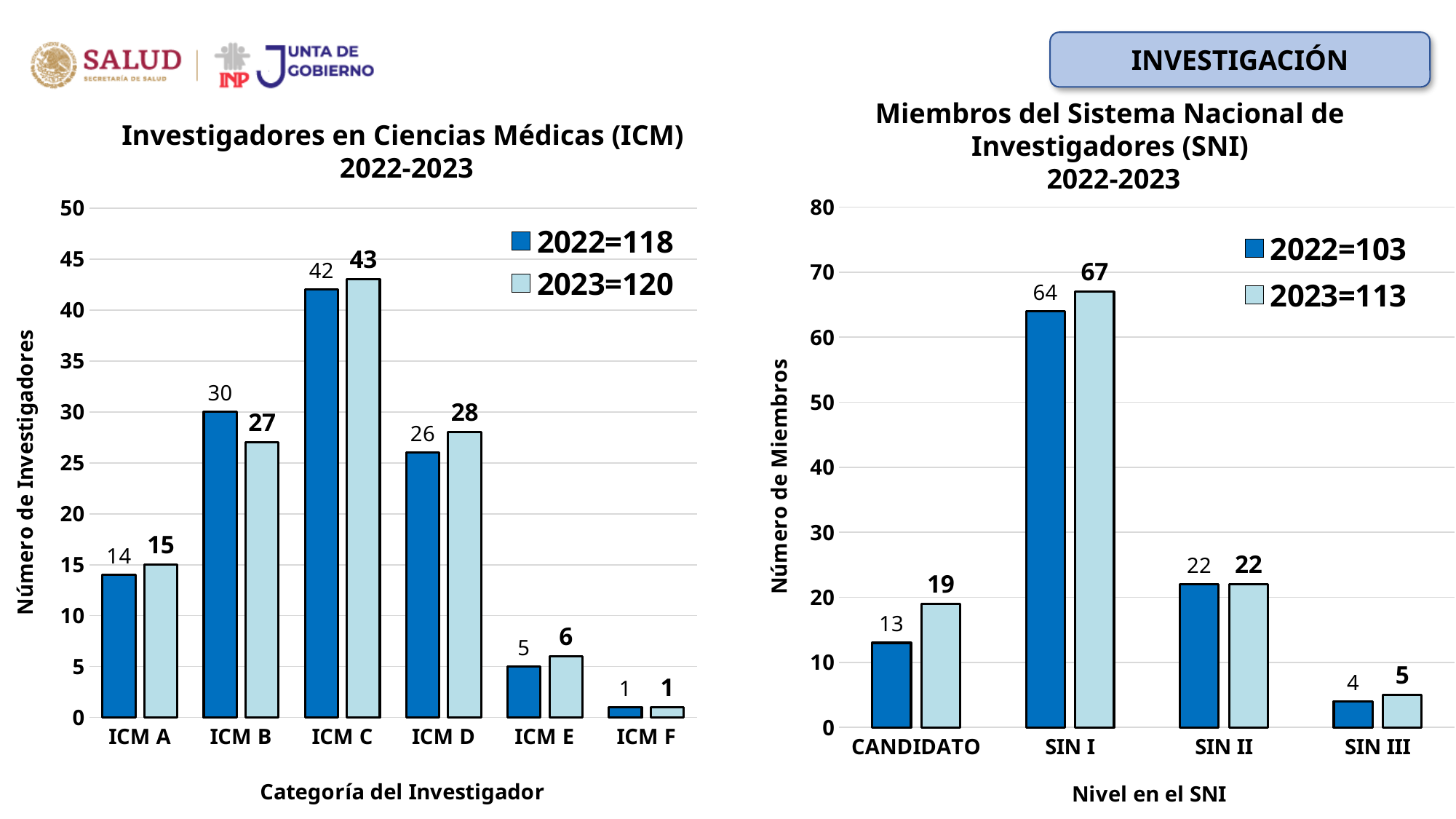
In the 'Miembros del Sistema Nacional de Investigadores (SNI) 2022-2023' chart, what total does the legend give for 2023? 113 In the 'Miembros del Sistema Nacional de Investigadores (SNI) 2022-2023' chart, which is larger: the 2022 value for CANDIDATO or the 2022 value for SIN II? SIN II In the 'Miembros del Sistema Nacional de Investigadores (SNI) 2022-2023' chart, what is the value for SIN I in 2022? 64 In the 'Investigadores en Ciencias Médicas (ICM) 2022-2023' chart, how many categories are shown on the x axis? 6 In the 'Miembros del Sistema Nacional de Investigadores (SNI) 2022-2023' chart, how many series does the legend list? 2 In the 'Investigadores en Ciencias Médicas (ICM) 2022-2023' chart, what is the value for ICM B in 2022? 30 In the 'Investigadores en Ciencias Médicas (ICM) 2022-2023' chart, what is the value for ICM C in 2023? 43 In the 'Miembros del Sistema Nacional de Investigadores (SNI) 2022-2023' chart, what is the value for CANDIDATO in 2023? 19 In the 'Investigadores en Ciencias Médicas (ICM) 2022-2023' chart, what kind of chart is it? Bar chart In the 'Investigadores en Ciencias Médicas (ICM) 2022-2023' chart, which category has the highest value in 2022? ICM C In the 'Investigadores en Ciencias Médicas (ICM) 2022-2023' chart, which category has the lowest value in 2023? ICM F In the 'Investigadores en Ciencias Médicas (ICM) 2022-2023' chart, what is the difference between the 2022 and 2023 values for ICM B? 3